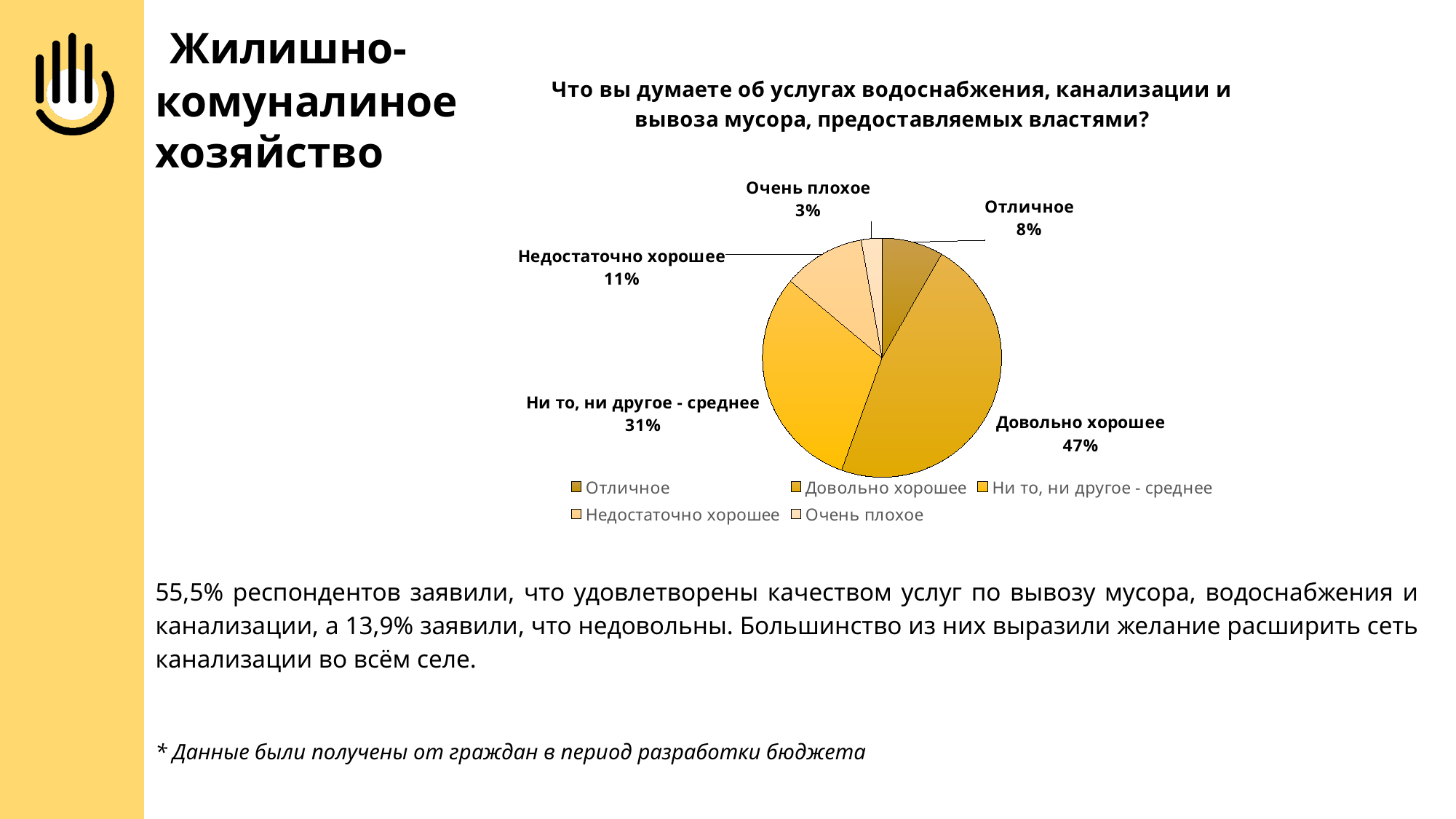
What is the difference in percentage points between "Довольно хорошее" and "Ни то, ни другое - среднее"? 16 What type of chart is shown on the slide? pie chart Which is larger, the share for "Отличное" or the share for "Недостаточно хорошее"? Недостаточно хорошее What percentage of respondents rated the services as "Ни то, ни другое - среднее"? 31% What percentage of respondents rated the services as "Очень плохое"? 3% What percentage of respondents rated the services as "Недостаточно хорошее"? 11% Which category has the largest share of the pie? Довольно хорошее What percentage of respondents rated the services as "Отличное"? 8% How many categories does the pie chart have? 5 What is the title of the chart? Что вы думаете об услугах водоснабжения, канализации и вывоза мусора, предоставляемых властями? Which category has the smallest share of the pie? Очень плохое What percentage of respondents rated the services as "Довольно хорошее"? 47%